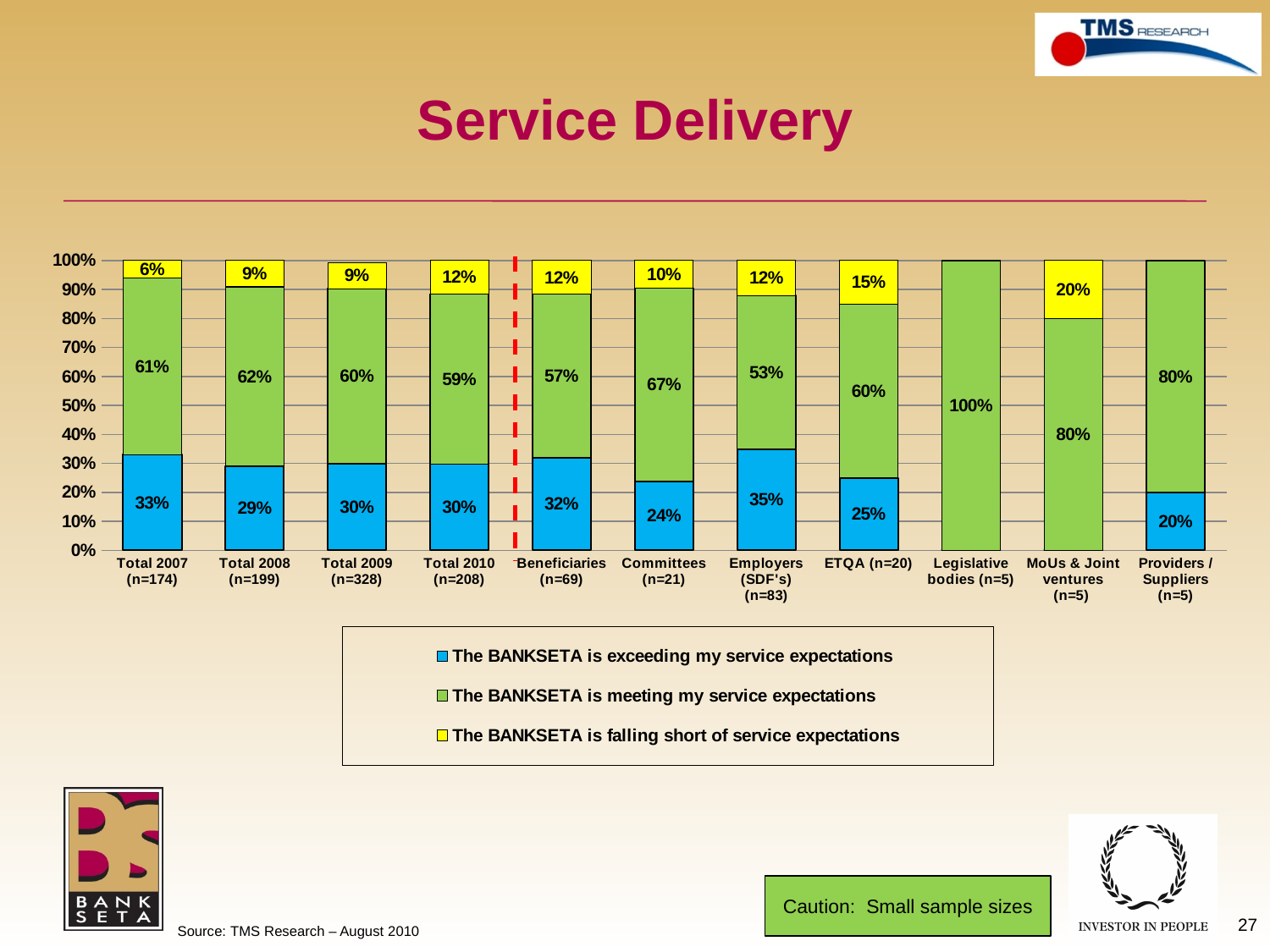
Among the four Total years, which has the lowest value for 'The BANKSETA is falling short of service expectations'? Total 2007 (n=174) How does the 'falling short' percentage change from Total 2007 to Total 2010? It rises What percentage of ETQA (n=20) said the BANKSETA is falling short of service expectations? 15% How many categories are shown along the x axis? 11 How many series does the legend list? 3 What is the difference between the 'exceeding' percentages for Total 2007 (n=174) and Total 2008 (n=199)? 4% Which is larger: the 'exceeding' value for Beneficiaries (n=69) or for Committees (n=21)? Beneficiaries (n=69) What percentage of Employers (SDF's) (n=83) said the BANKSETA is exceeding their service expectations? 35% What colour represents 'The BANKSETA is falling short of service expectations'? Yellow What type of chart is shown on the slide? Stacked bar chart Which category has the highest value for 'The BANKSETA is meeting my service expectations'? Legislative bodies (n=5) What percentage of Committees (n=21) said the BANKSETA is meeting their service expectations? 67%